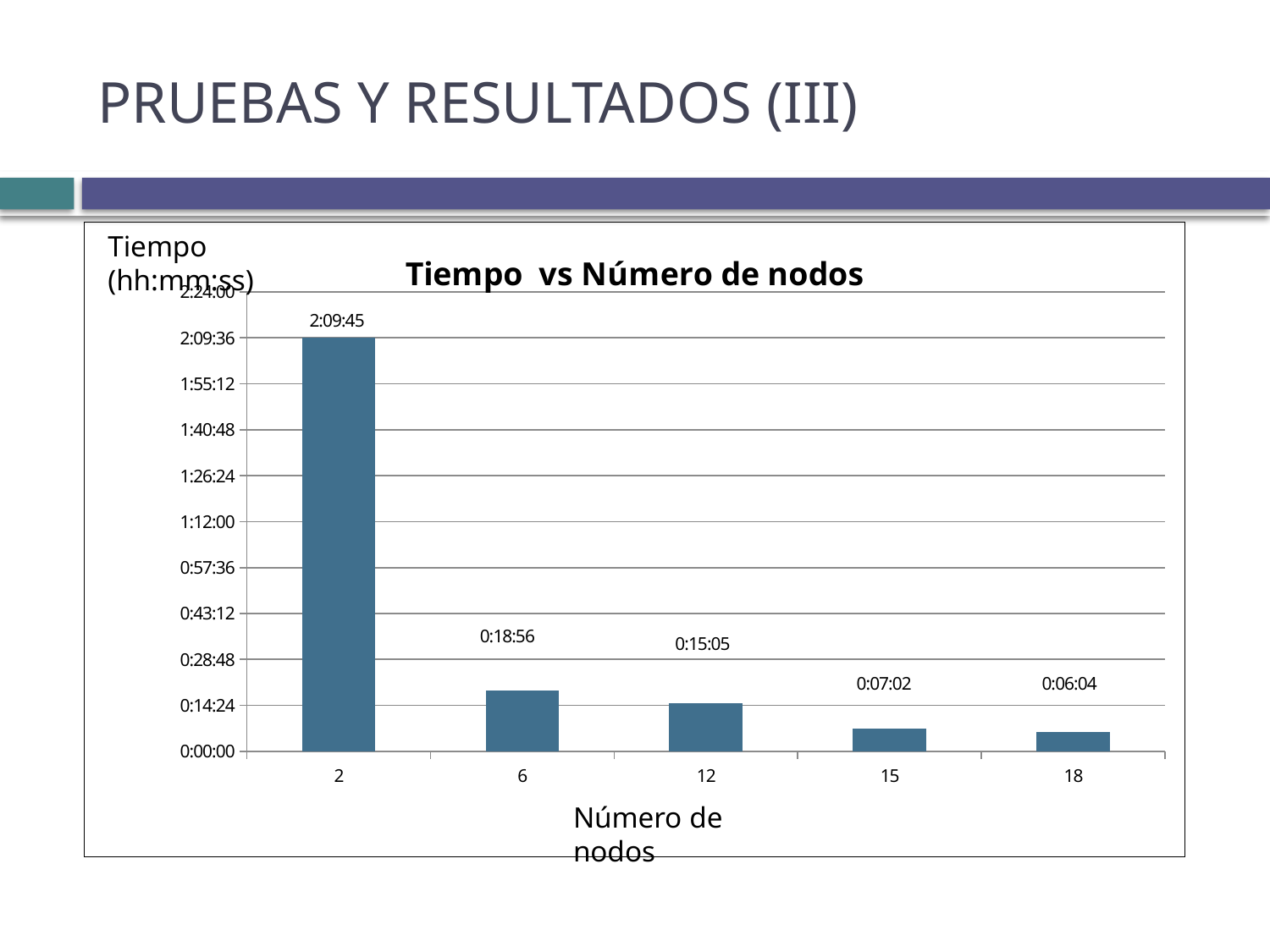
Which has a larger time value, 6 nodes or 12 nodes? 6 nodes Does the time rise or fall as the number of nodes increases along the x axis? Fall What is the time value for 18 nodes? 0:06:04 Which number of nodes has the lowest time? 18 What is the time value for 2 nodes? 2:09:45 What kind of chart is shown on the slide? Bar chart What is the difference in time between 2 nodes and 6 nodes? 1:50:49 Which number of nodes has the highest time? 2 How many node counts are plotted on the chart? 5 What is the time value for 12 nodes? 0:15:05 What is the time value for 6 nodes? 0:18:56 What is the difference in time between 15 nodes and 18 nodes? 0:00:58